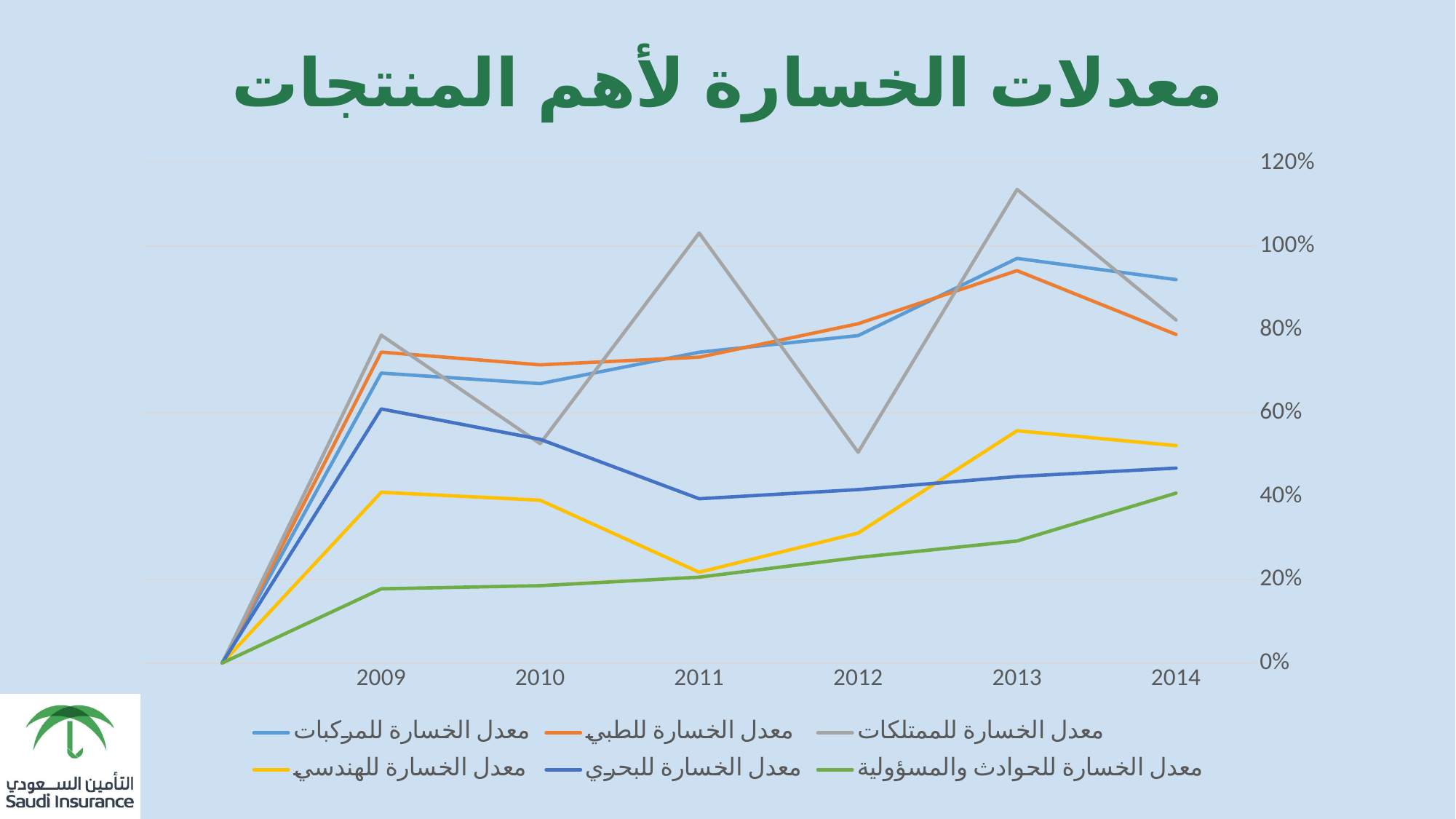
Which series has the highest value in 2013? معدل الخسارة للممتلكات Does the line for معدل الخسارة للحوادث والمسؤولية rise or fall from 2009 to 2014? rise Which series has the highest value in 2011? معدل الخسارة للممتلكات How many series does the legend list? 6 Is the value for معدل الخسارة للحوادث والمسؤولية in 2009 greater or less than 20%? less What kind of chart is shown on the slide? line chart Is the value for معدل الخسارة للهندسي in 2013 greater or less than 60%? less Which series has the lowest value in 2009? معدل الخسارة للحوادث والمسؤولية Is the value for معدل الخسارة للممتلكات in 2013 greater or less than 100%? greater Which is larger for معدل الخسارة للممتلكات: the value in 2012 or the value in 2013? 2013 How many years are labeled on the x axis? 6 What is the title of the chart? معدلات الخسارة لأهم المنتجات